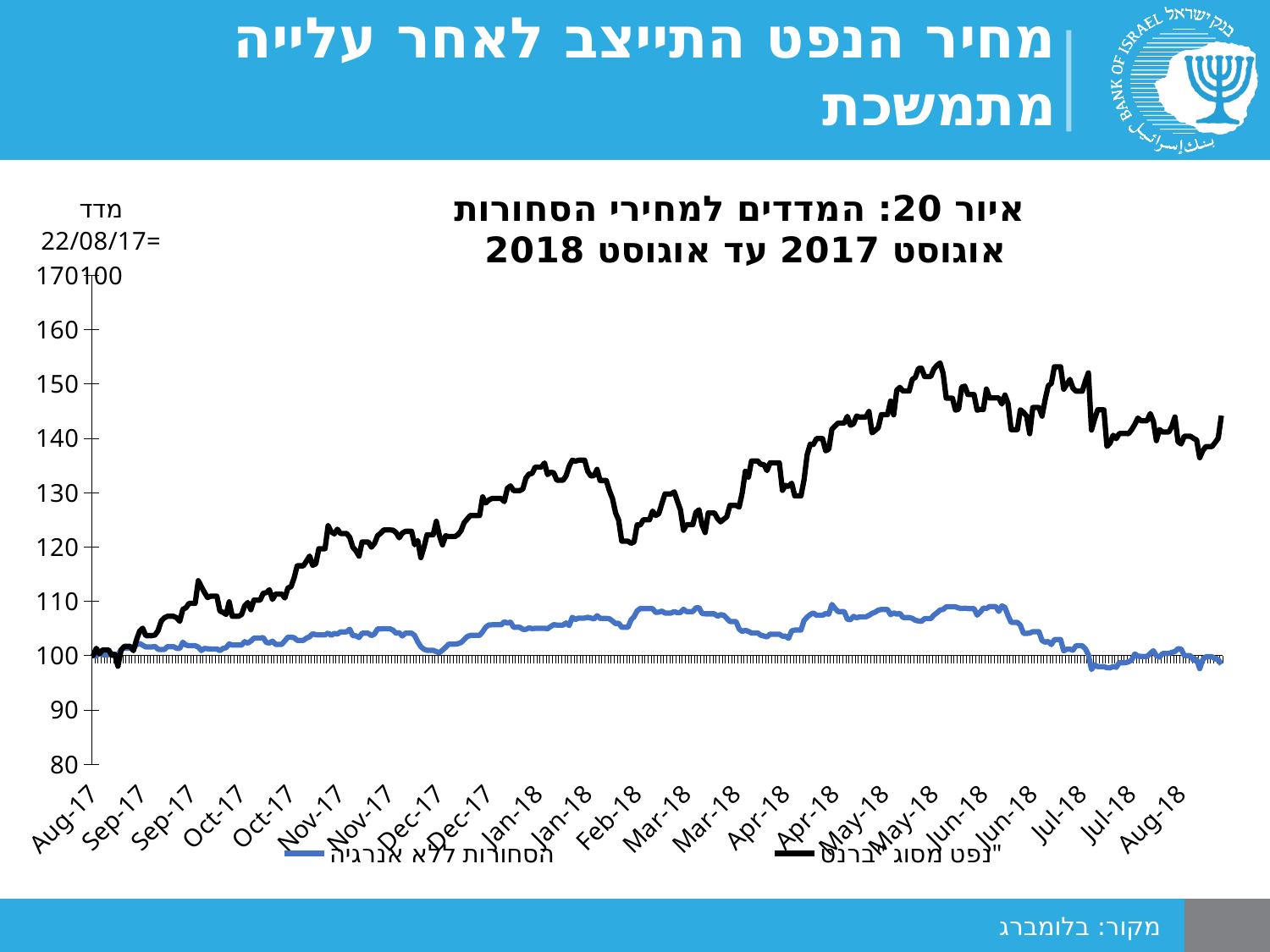
What kind of chart is shown on the slide? line chart How many series does the legend list? 2 Which series is drawn with the black line? נפט מסוג ברנט Which series ends lower at Aug-18, נפט מסוג ברנט or סחורות ללא אנרגיה? סחורות ללא אנרגיה Which series is drawn with the blue line? הסחורות ללא אנרגיה What is the highest value shown on the vertical axis? 170 Which series is higher around Jun-18, נפט מסוג ברנט or סחורות ללא אנרגיה? נפט מסוג ברנט Is the value for סחורות ללא אנרגיה around Mar-18 greater or less than 120? less Is the value for נפט מסוג ברנט at the end of the series (Aug-18) greater or less than 130? greater Is the value for נפט מסוג ברנט around May-18 greater or less than 140? greater Overall, does the נפט מסוג ברנט line rise or fall from Aug-17 to Aug-18? rise